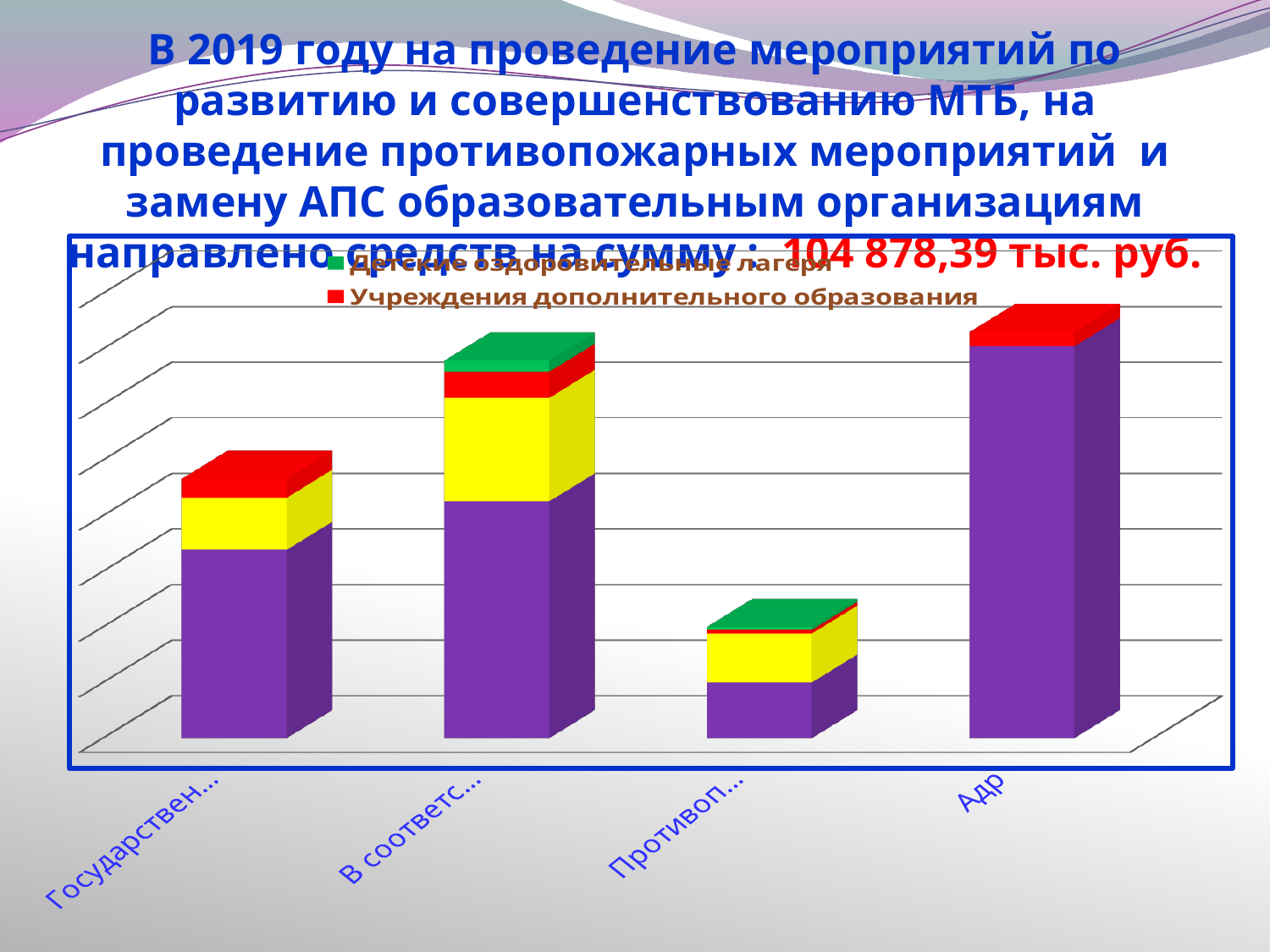
What colour represents the series 'Учреждения дополнительного образования' in the legend? Red Which category has the tallest bar in the chart? АДР Which bar is taller: the one for 'АДР' or the one for 'Государствен...'? АДР What colour represents the series 'Детские оздоровительные лагеря' in the legend? Green Which bar is taller: the one for 'В соответс...' or the one for 'Противоп...'? В соответс... Which category has the second tallest bar in the chart? В соответс... How many categories are shown along the x axis of the chart? 4 What kind of chart is shown on the slide? Stacked bar chart Which category has the shortest bar in the chart? Противоп... Which bar is taller: the one for 'Государствен...' or the one for 'В соответс...'? В соответс...